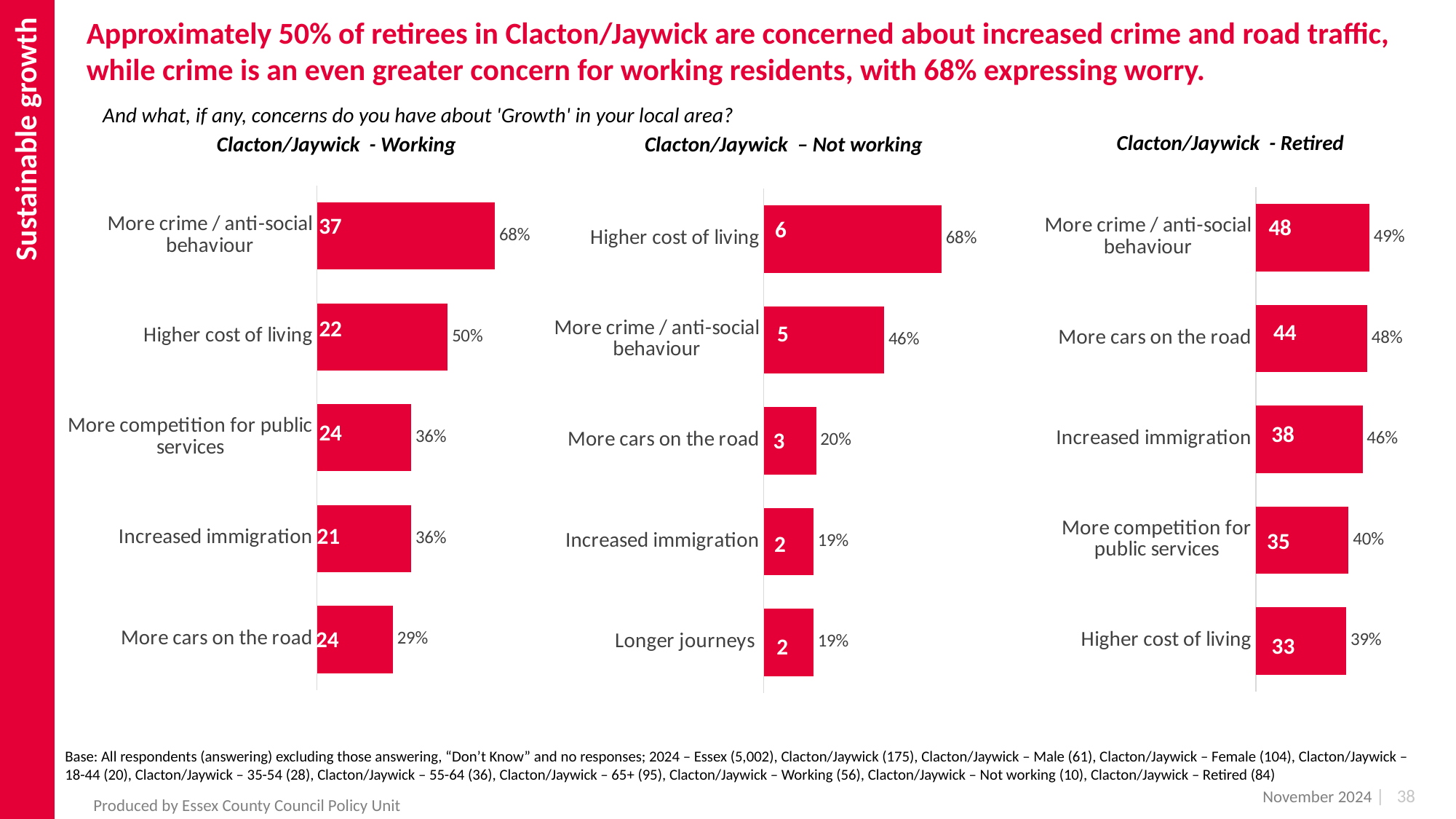
In the 'Clacton/Jaywick - Retired' chart, which concern has the lowest percentage? Higher cost of living What type of chart is used for 'Clacton/Jaywick - Working'? Bar chart In the 'Clacton/Jaywick - Retired' chart, what percentage is shown for 'Increased immigration'? 46% In the 'Clacton/Jaywick - Working' chart, what count is printed inside the bar for 'Higher cost of living'? 22 How many charts are shown on the slide? 3 How many concerns are listed in the 'Clacton/Jaywick – Not working' chart? 5 In the 'Clacton/Jaywick - Working' chart, what is the difference in percentage points between 'More crime / anti-social behaviour' and 'More cars on the road'? 39 In the 'Clacton/Jaywick – Not working' chart, which concern has the highest percentage? Higher cost of living In the 'Clacton/Jaywick – Not working' chart, what count is printed inside the bar for 'Longer journeys'? 2 In the 'Clacton/Jaywick - Retired' chart, which has a higher percentage: 'More cars on the road' or 'More competition for public services'? More cars on the road In the 'Clacton/Jaywick - Working' chart, what percentage is shown for 'More crime / anti-social behaviour'? 68% In the 'Clacton/Jaywick – Not working' chart, what percentage is shown for 'More cars on the road'? 20%